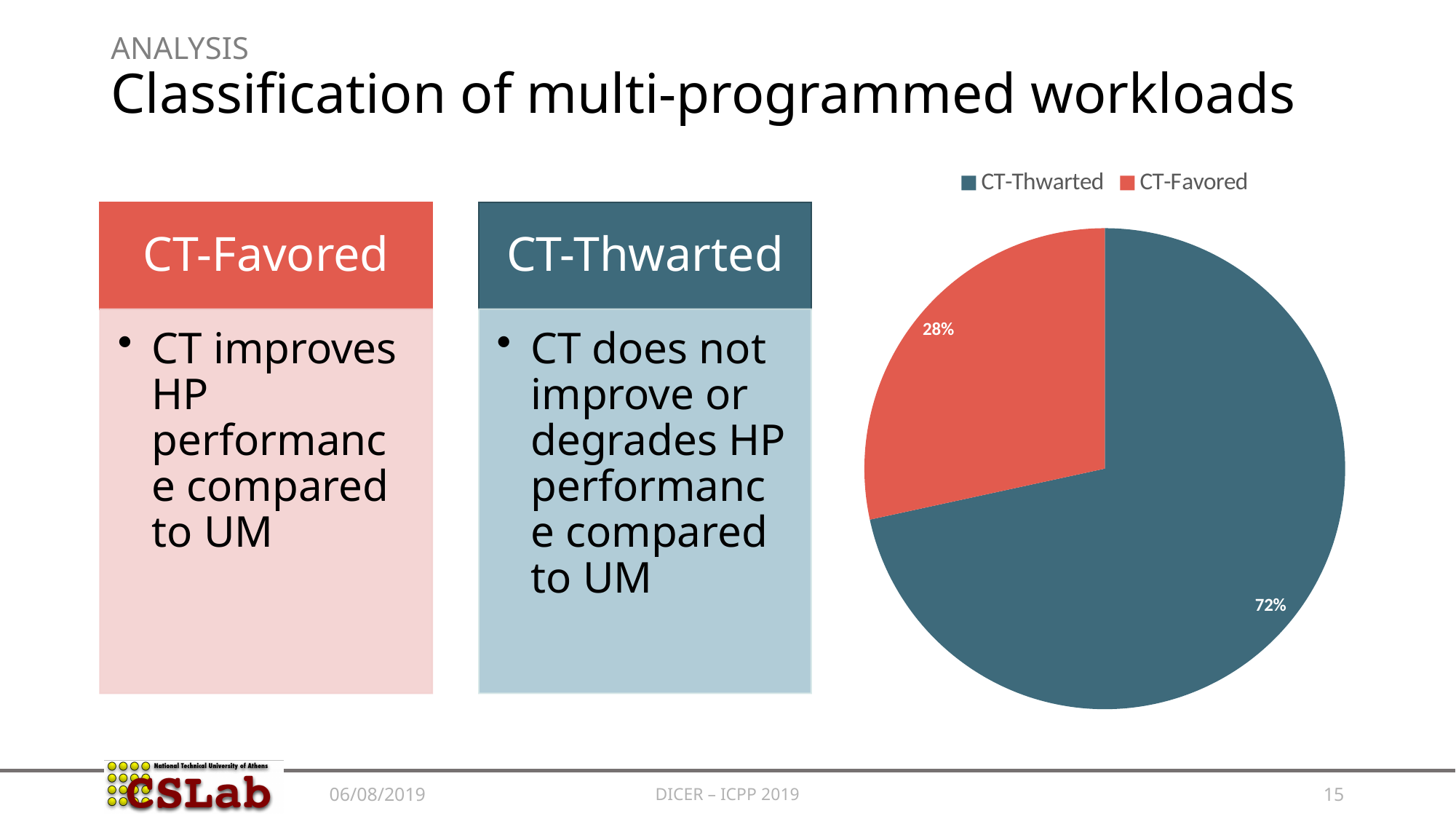
How many entries does the legend list? 2 What is the difference in percentage points between the CT-Thwarted and CT-Favored slices? 44 How many slices does the pie chart have? 2 Which legend entry is listed first in the pie chart's legend? CT-Thwarted Which is larger, the CT-Favored slice or the CT-Thwarted slice? CT-Thwarted Which slice of the pie is the largest? CT-Thwarted What share of the pie does CT-Favored take? 28% Which slice of the pie is the smallest? CT-Favored What colour is the CT-Favored slice in the pie chart? red What kind of chart is shown on the slide? pie chart What share of the pie does CT-Thwarted take? 72%